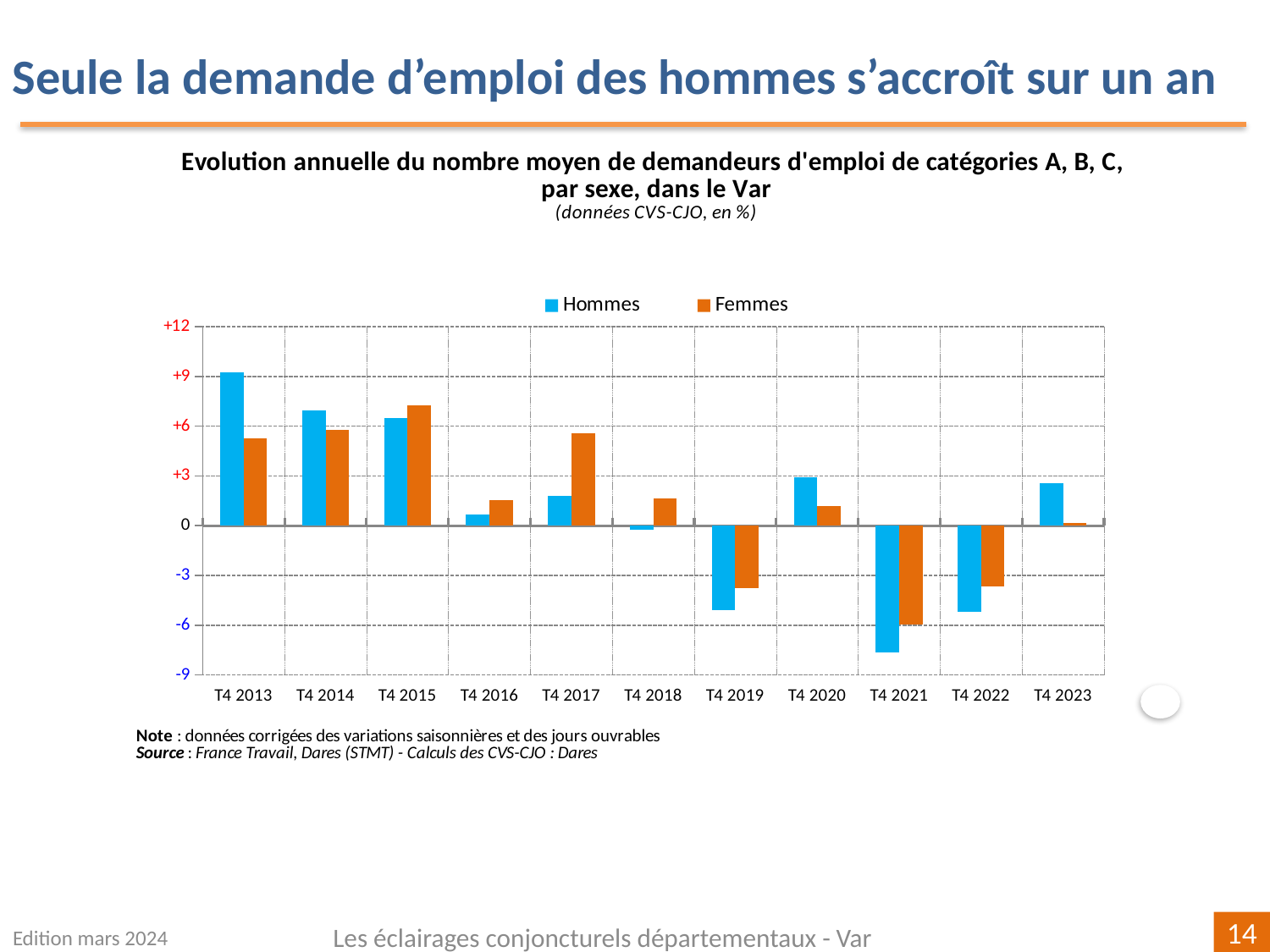
Is the value for Hommes in T4 2013 greater or less than +6? greater How many periods (categories) are shown on the x axis? 11 In which period is the value for Hommes the lowest? T4 2021 In which period is the value for Femmes the lowest? T4 2021 Is the value for Femmes in T4 2021 greater or less than -3? less In which period is the value for Femmes the highest? T4 2015 In T4 2017, which series has the larger value, Hommes or Femmes? Femmes In which period is the value for Hommes the highest? T4 2013 Which colour represents the Hommes series in the chart? blue What kind of chart is shown on the slide? bar chart How many series does the legend list? 2 In T4 2023, which series has the larger value, Hommes or Femmes? Hommes